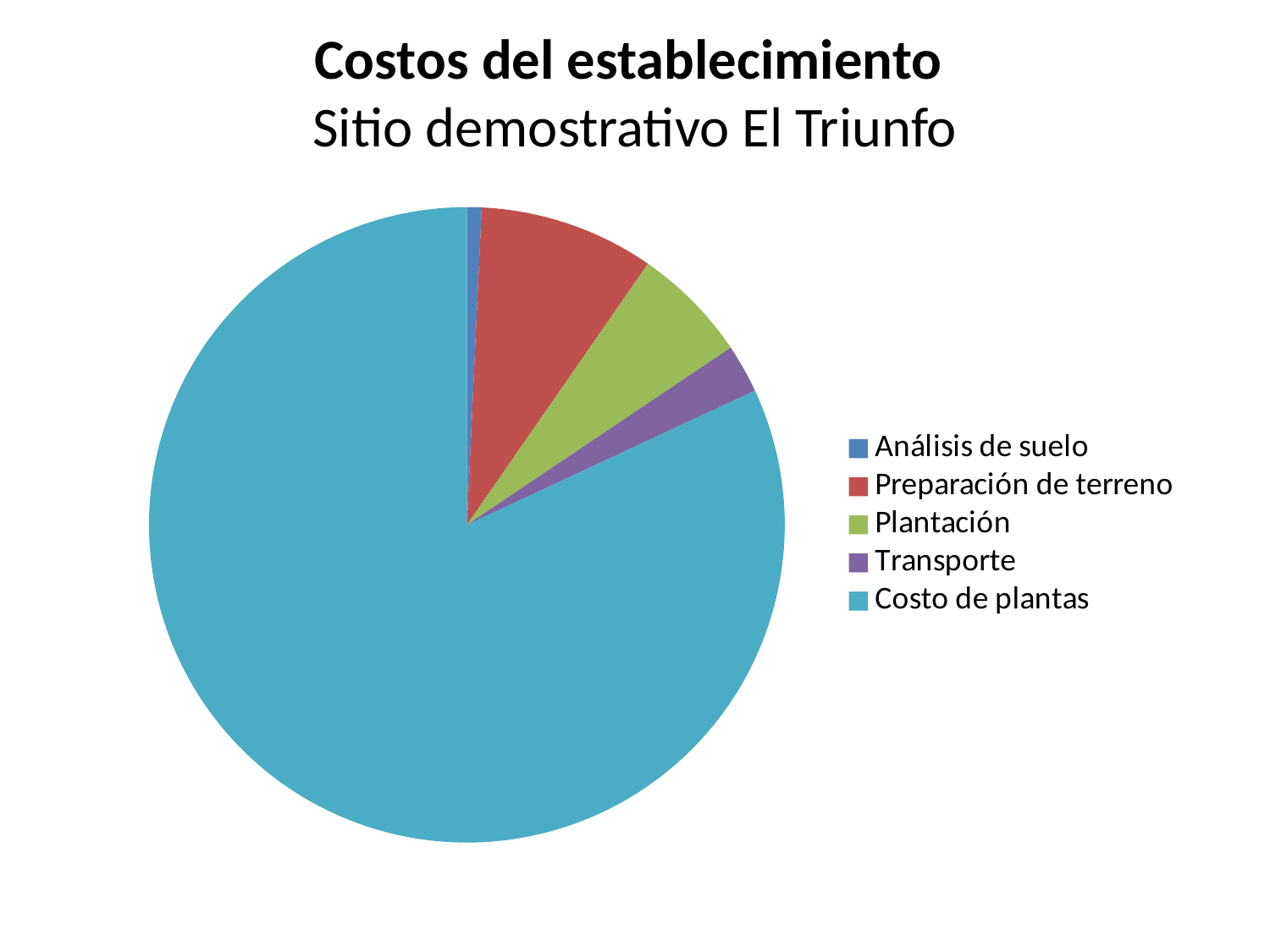
Which slice is larger, Preparación de terreno or Plantación? Preparación de terreno What is the title of the chart? Costos del establecimiento Sitio demostrativo El Triunfo Which category is shown in red in the legend? Preparación de terreno How many slices does the pie chart have? 5 Which slice is larger, Transporte or Análisis de suelo? Transporte Which slice is larger, Costo de plantas or Preparación de terreno? Costo de plantas What kind of chart is shown on the slide? Pie chart Which category has the largest slice of the pie? Costo de plantas Which category has the smallest slice of the pie? Análisis de suelo